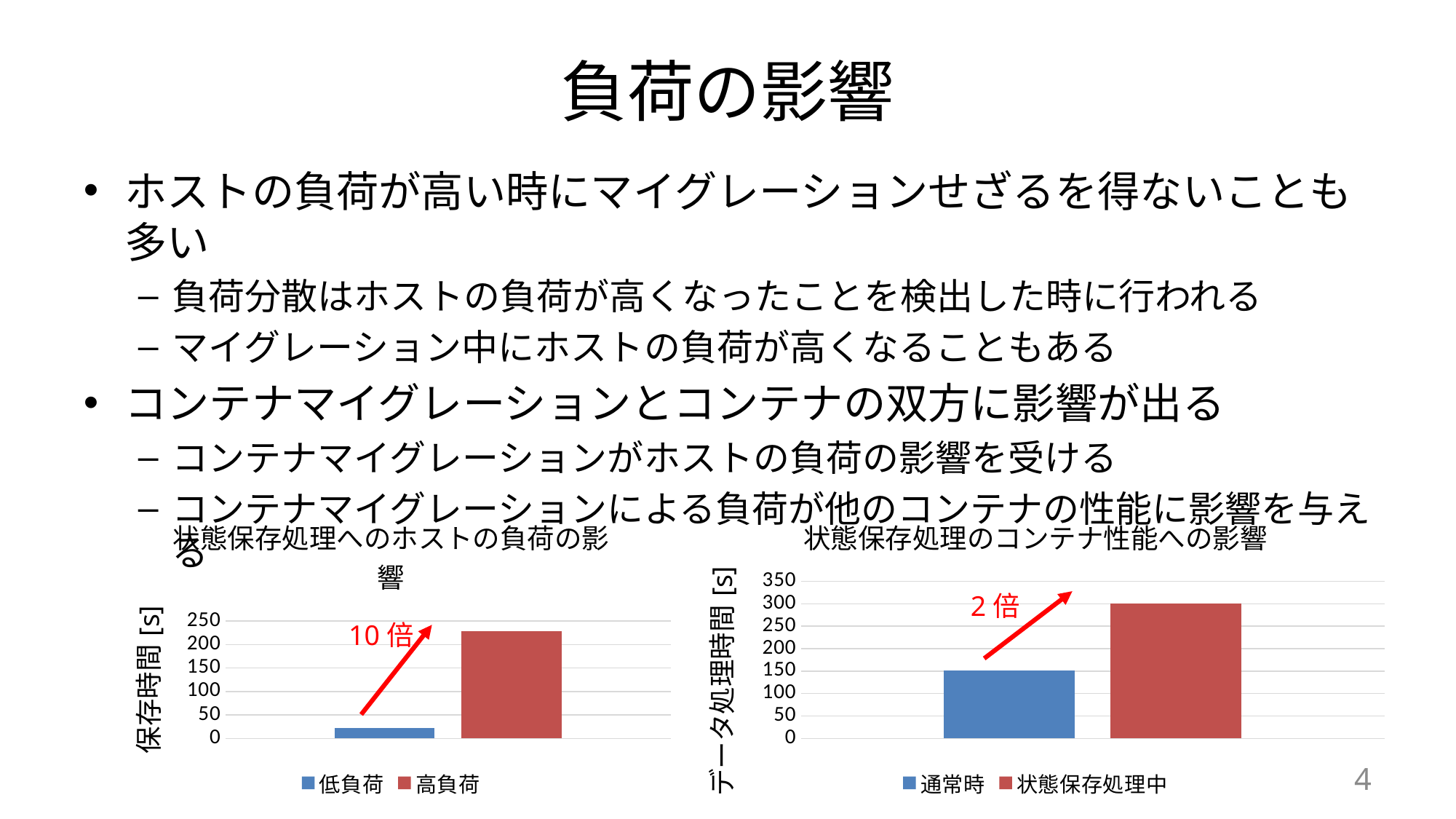
In the right chart (状態保存処理のコンテナ性能への影響), which series has the lower データ処理時間? 通常時 What ratio is written in the red annotation on the left chart (状態保存処理へのホストの負荷の影響)? 10 倍 What is the y-axis label of the left chart (状態保存処理へのホストの負荷の影響)? 保存時間 [s] How many series does the legend of the right chart (状態保存処理のコンテナ性能への影響) list? 2 How many series does the legend of the left chart (状態保存処理へのホストの負荷の影響) list? 2 In the right chart (状態保存処理のコンテナ性能への影響), is the value for 状態保存処理中 greater or less than 250? greater In the left chart (状態保存処理へのホストの負荷の影響), which series has the higher 保存時間, 低負荷 or 高負荷? 高負荷 In the left chart (状態保存処理へのホストの負荷の影響), is the value for 高負荷 greater or less than 200? greater In the left chart (状態保存処理へのホストの負荷の影響), is the value for 低負荷 greater or less than 50? less What type of chart is the left chart titled 状態保存処理へのホストの負荷の影響? bar chart